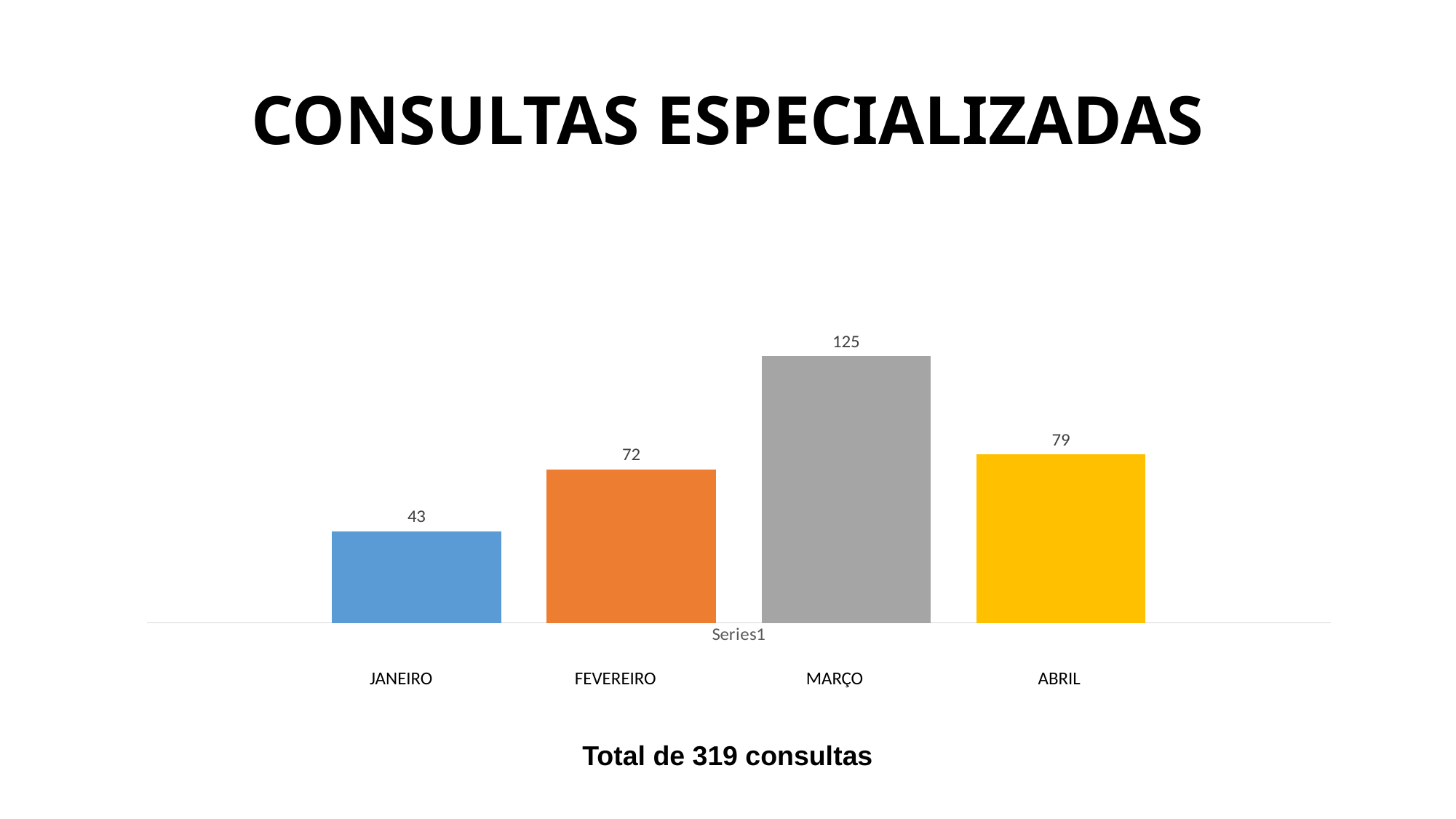
What is the value for MARÇO? 125 Which month has the highest value? MARÇO Which is larger, the value for FEVEREIRO or the value for ABRIL? ABRIL What is the difference between the values for ABRIL and FEVEREIRO? 7 How many months are shown in the chart? 4 What is the difference between the values for MARÇO and JANEIRO? 82 What is the value for ABRIL? 79 What is the title of the slide? CONSULTAS ESPECIALIZADAS What kind of chart is shown on the slide? bar chart What is the value for FEVEREIRO? 72 What is the value for JANEIRO? 43 Which month has the lowest value? JANEIRO